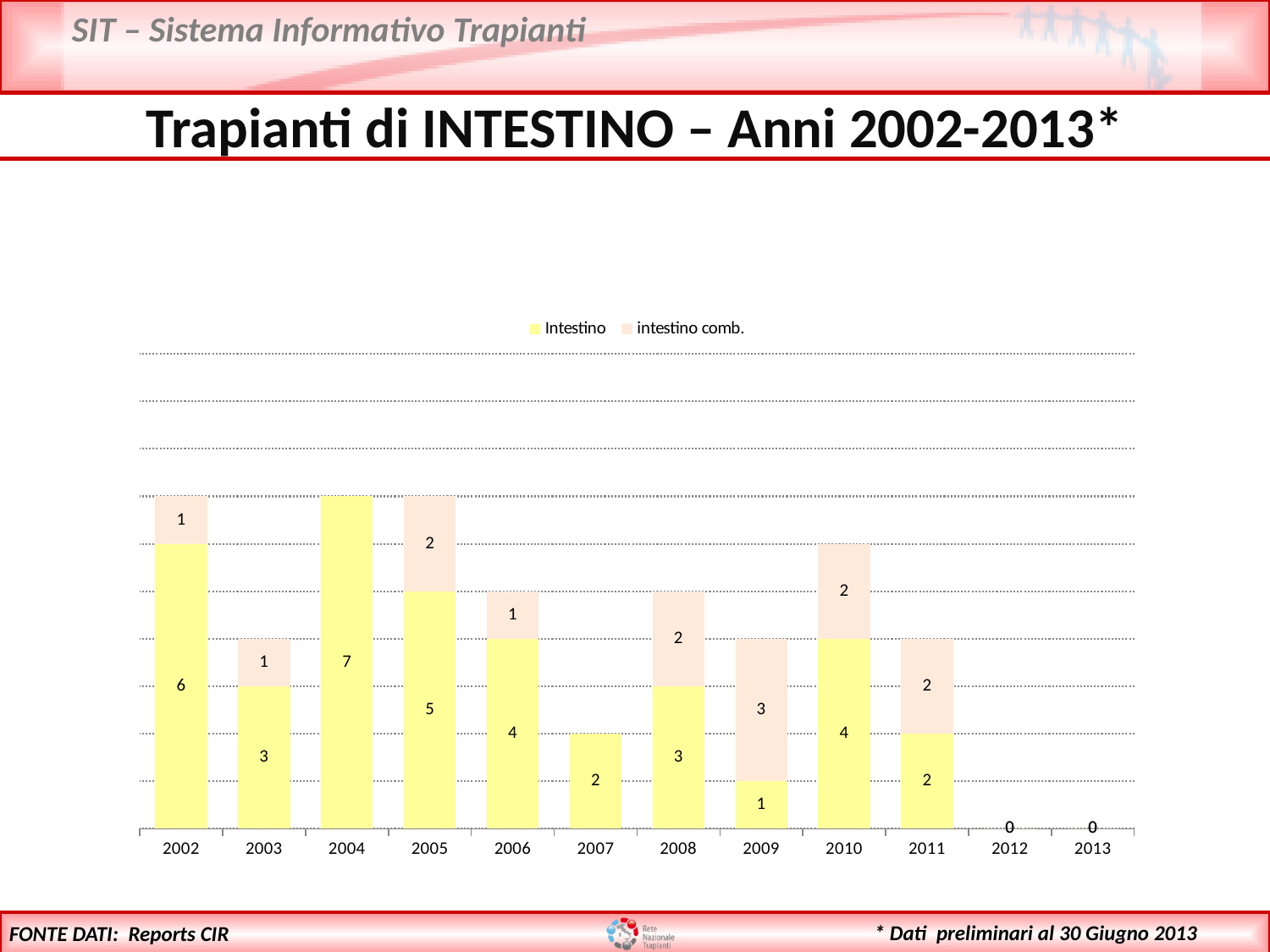
What value is shown for 2012? 0 What is the total of the stacked bar for 2002? 7 What is the intestino comb. value for 2009? 3 What is the difference between the Intestino values for 2002 and 2003? 3 How many series does the legend list? 2 How many years are shown on the x axis? 12 What is the Intestino value for 2004? 7 What are the two series named in the legend? Intestino and intestino comb. Which year has the larger Intestino value, 2010 or 2011? 2010 What kind of chart is shown on the slide? bar chart Which year has the highest Intestino value? 2004 What is the total of the stacked bar for 2005? 7